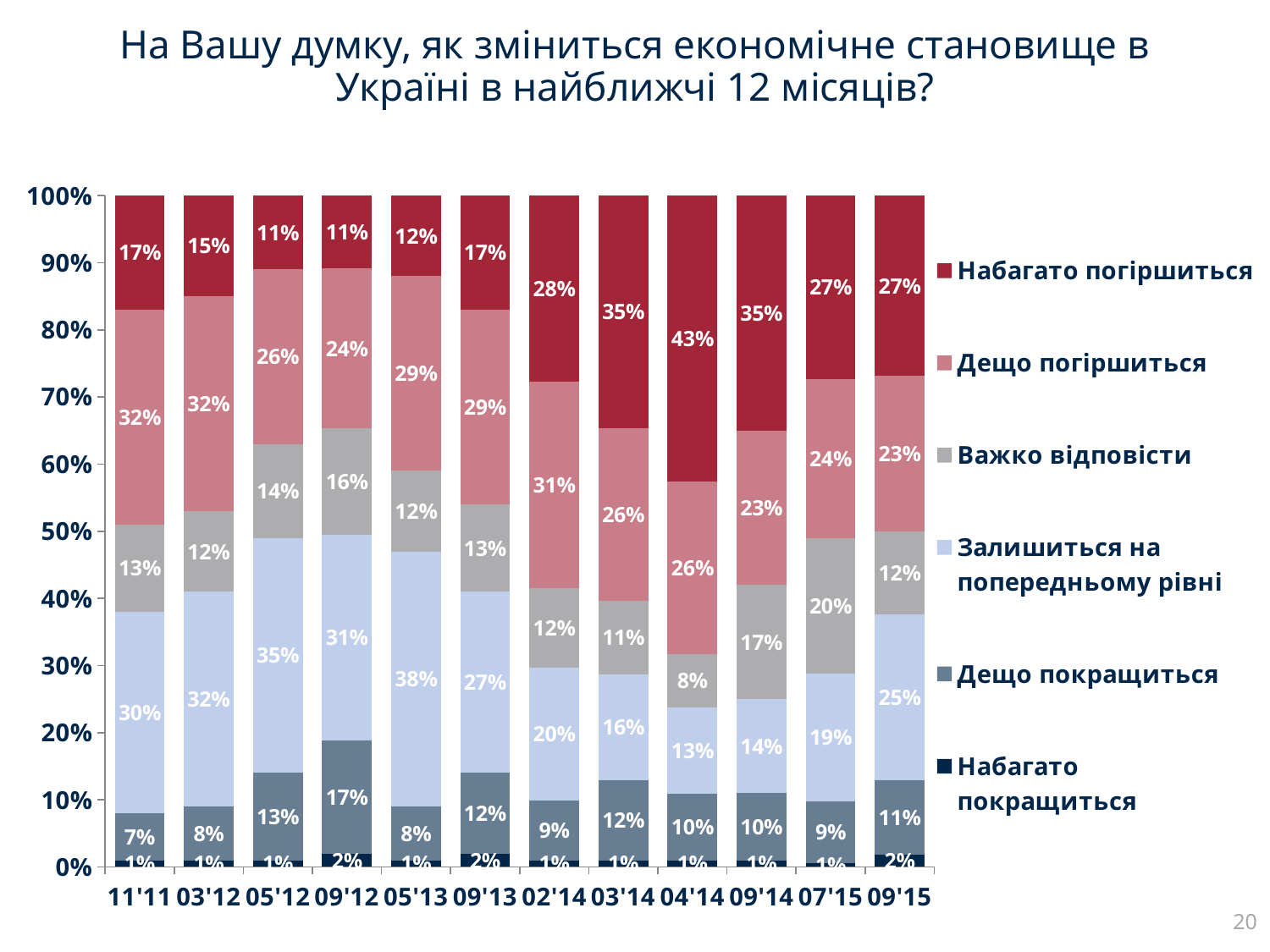
In which period is the "Набагато погіршиться" share the highest? 04'14 What share answered "Дещо покращиться" in 09'12? 17% What type of chart is shown on the slide? Stacked bar chart What is the combined share of "Дещо погіршиться" and "Набагато погіршиться" in 03'14? 61% What percentage of respondents answered "Набагато погіршиться" in 04'14? 43% How many time periods are shown on the x axis? 12 Which legend entry is shown in the darkest red colour? Набагато погіршиться Which is larger: the "Важко відповісти" value in 07'15 or in 09'15? 07'15 How many series does the legend list? 6 What is the value for "Залишиться на попередньому рівні" in 05'13? 38% In which period is the "Залишиться на попередньому рівні" share the lowest? 04'14 What is the difference between the "Набагато погіршиться" values for 04'14 and 09'15? 16%